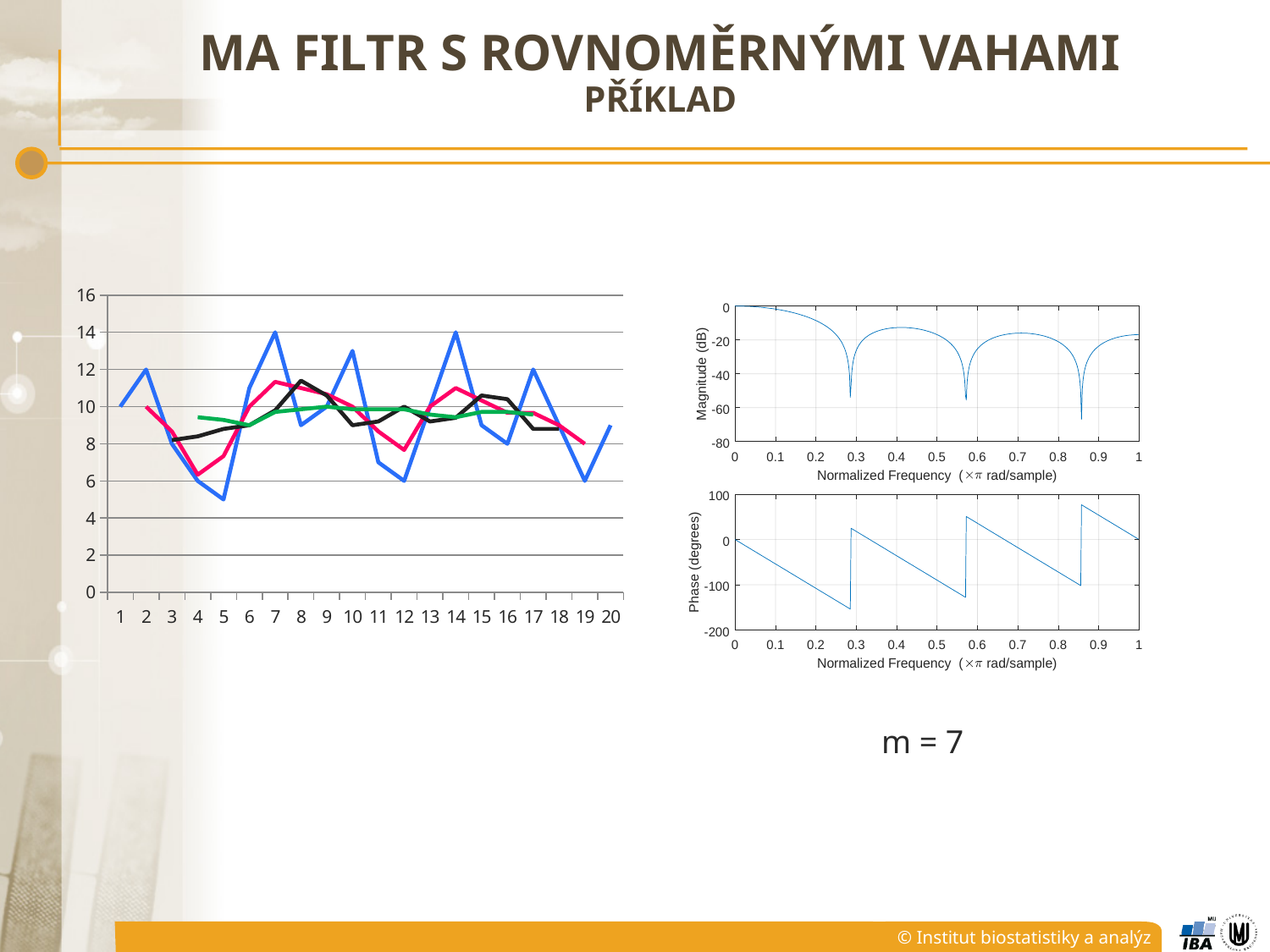
What is the x-axis label of the bottom chart on the right of the slide? Normalized Frequency (×π rad/sample) In the chart on the left of the slide, is the value of the blue line at x = 5 greater or less than 6? less How many points are on the x axis of the chart on the left of the slide? 20 In the chart on the left of the slide, is the value of the blue line at x = 10 greater or less than 12? greater In the chart on the left of the slide, which line is higher at x = 7, the blue line or the green line? blue line In the chart on the left of the slide, at which x value does the blue line reach its lowest point? 5 What is the y-axis label of the top chart on the right of the slide? Magnitude (dB) In the chart on the left of the slide, what is the value of the blue line at x = 2? 12 In the chart on the left of the slide, is the value of the red line at x = 4 greater or less than 8? less In the chart on the left of the slide, what is the value of the blue line at x = 7? 14 What kind of chart is the chart on the left of the slide? line chart How many lines are plotted in the chart on the left of the slide? 4